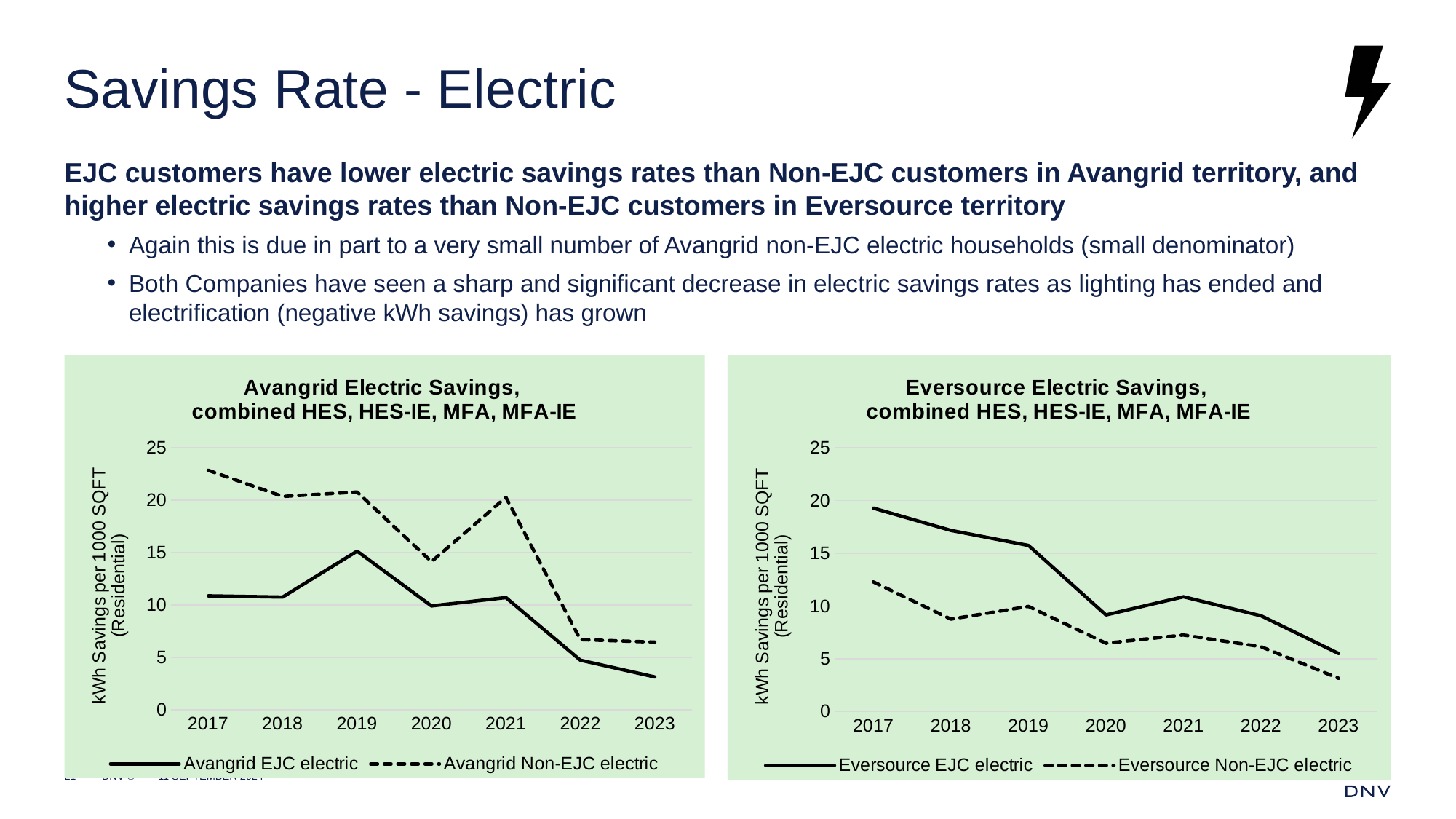
In the Eversource Electric Savings chart, which series has the larger value in 2023, Eversource EJC electric or Eversource Non-EJC electric? Eversource EJC electric In the Avangrid Electric Savings chart, in which year is the Avangrid EJC electric line at its lowest? 2023 In the Avangrid Electric Savings chart, how many years are shown on the x axis? 7 In the Eversource Electric Savings chart, does the Eversource EJC electric line generally rise or fall from 2017 to 2023? Fall In the Avangrid Electric Savings chart, which series has the larger value in 2021, Avangrid EJC electric or Avangrid Non-EJC electric? Avangrid Non-EJC electric In the Avangrid Electric Savings chart, is the Avangrid Non-EJC electric value for 2017 greater or less than 20? greater In the Avangrid Electric Savings chart, how many series does the legend list? 2 What is the y-axis label on the Eversource Electric Savings chart? kWh Savings per 1000 SQFT (Residential) What type of chart is the Avangrid Electric Savings chart on the left? Line chart In the Eversource Electric Savings chart, in which year is the Eversource Non-EJC electric line at its highest? 2017 In the Eversource Electric Savings chart, is the Eversource EJC electric value for 2020 greater or less than 10? less In the Avangrid Electric Savings chart, in which year is the Avangrid EJC electric line at its highest? 2019